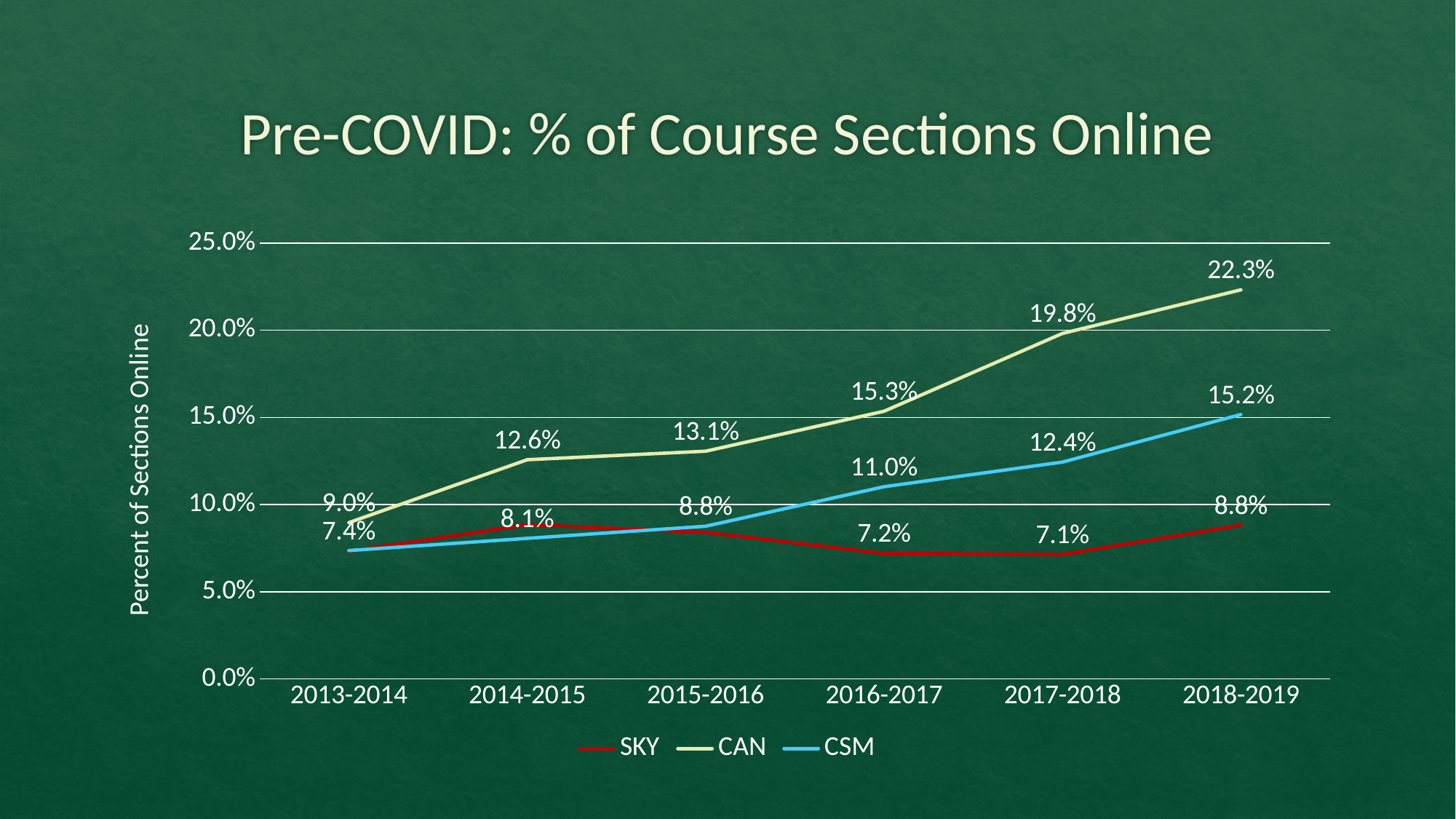
What is the title of the chart? Pre-COVID: % of Course Sections Online What was the CSM value in 2016-2017? 11.0% How many academic years are shown on the x axis? 6 In which year was the CAN value lowest? 2013-2014 In 2016-2017, which was larger: CSM or SKY? CSM Does the CAN series rise or fall from 2013-2014 to 2018-2019? Rises What was the CAN value in 2018-2019? 22.3% What is the difference between the CAN and CSM values in 2018-2019? 7.1 percentage points What type of chart is shown on the slide? Line chart What was the SKY value in 2017-2018? 7.1% How many series does the legend list? 3 Which series had the highest value in 2018-2019? CAN